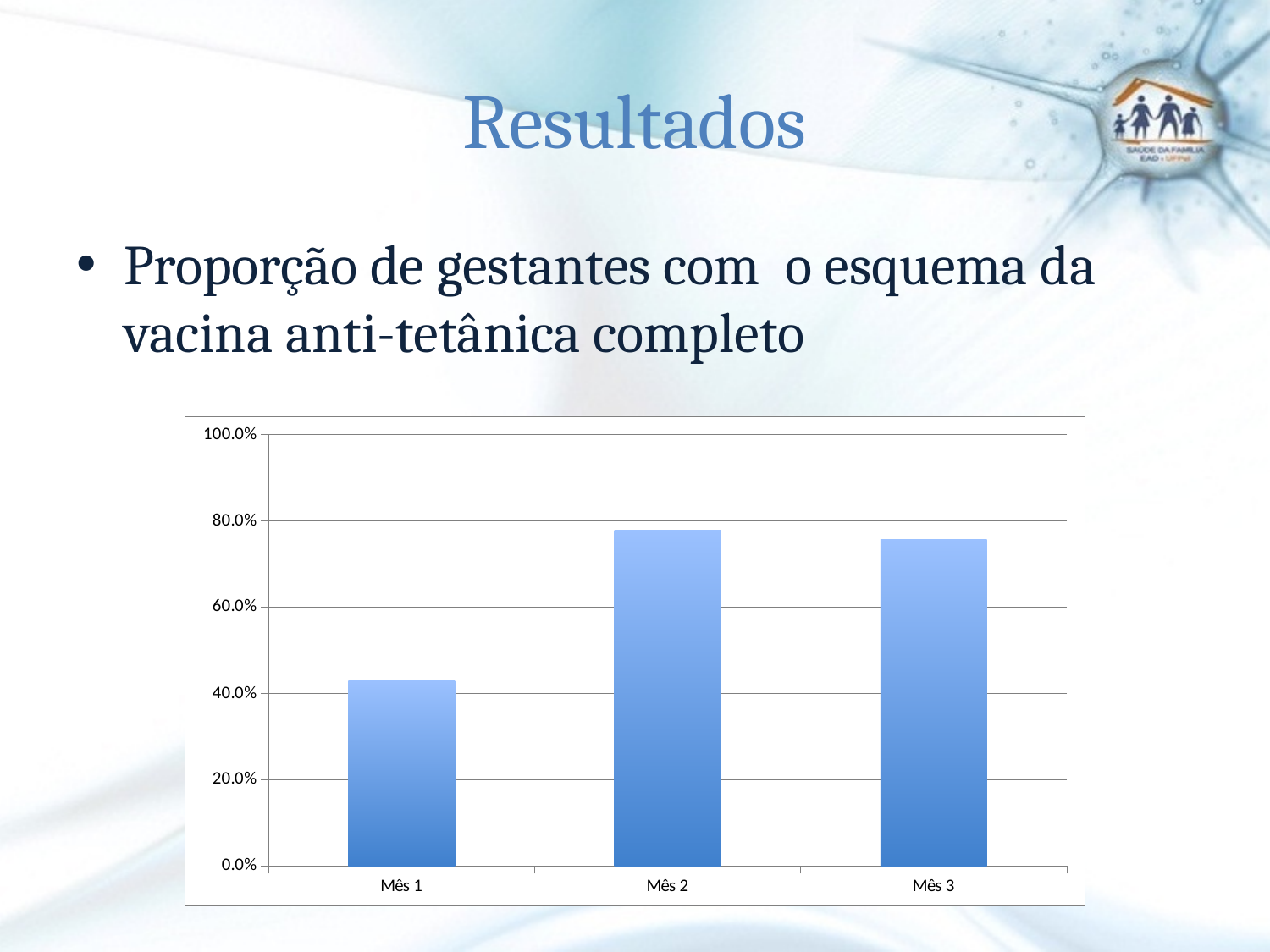
What is the highest value shown on the chart's vertical axis? 100.0% Is the value for Mês 1 greater or less than 60.0%? less Which is larger, the value for Mês 1 or the value for Mês 3? Mês 3 Does the value rise or fall from Mês 1 to Mês 2? rise Is the value for Mês 2 greater or less than 80.0%? less Is the value for Mês 3 greater or less than 60.0%? greater Which category has the lowest value in the chart? Mês 1 What kind of chart is shown on the slide? bar chart How many categories are plotted on the x axis of the chart? 3 Which is larger, the value for Mês 1 or the value for Mês 2? Mês 2